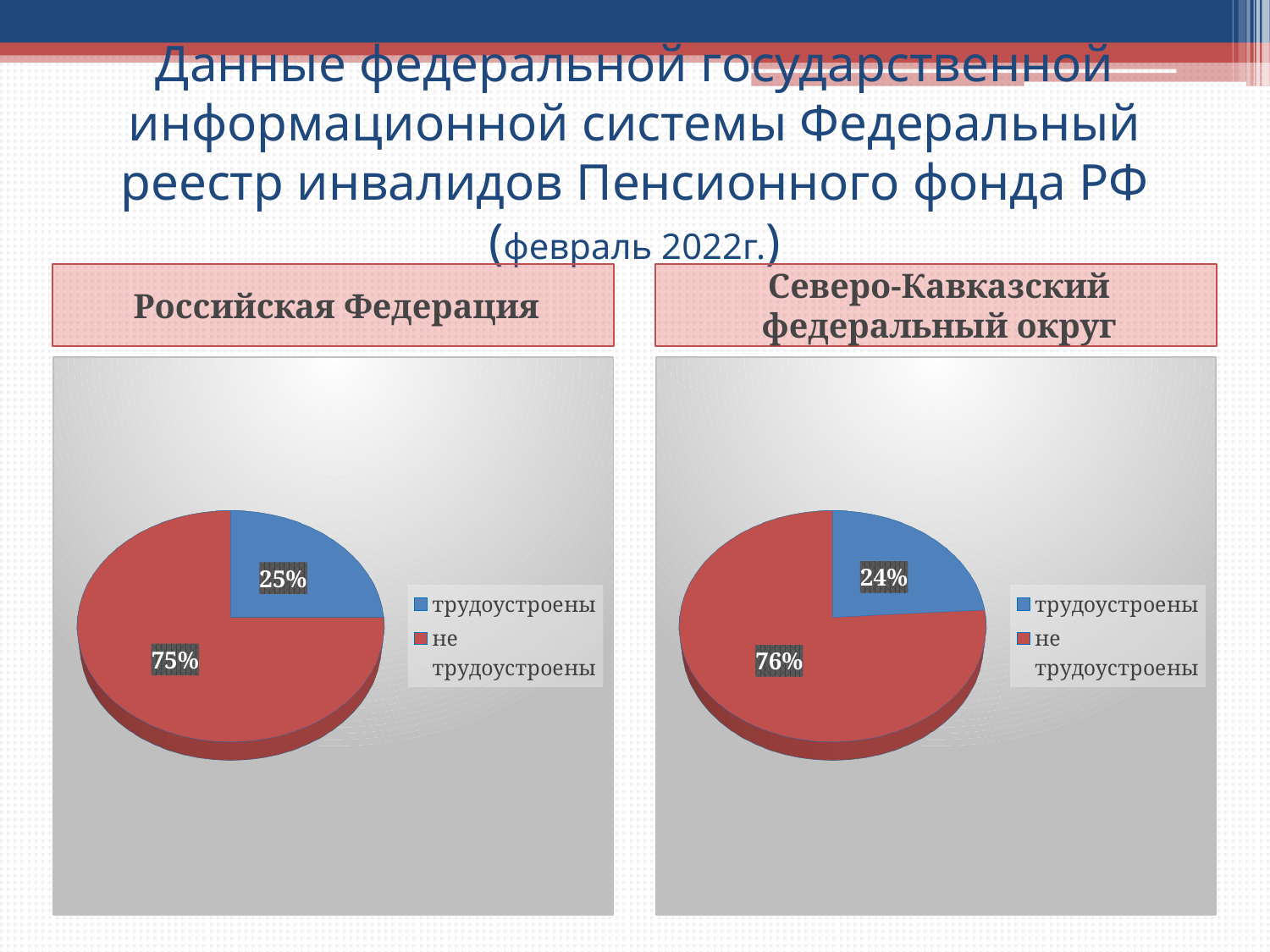
Which is larger: the 'трудоустроены' share in the 'Российская Федерация' chart or in the 'Северо-Кавказский федеральный округ' chart? Российская Федерация How many slices does the 'Северо-Кавказский федеральный округ' pie chart have? 2 In the 'Российская Федерация' chart, which category has the largest slice? не трудоустроены In the 'Российская Федерация' chart, what share is labelled 'трудоустроены'? 25% In the 'Российская Федерация' chart, what is the difference between the 'не трудоустроены' and 'трудоустроены' shares? 50% In the 'Северо-Кавказский федеральный округ' chart, which category has the smallest slice? трудоустроены What type of chart is used in the 'Российская Федерация' chart? Pie chart In the 'Российская Федерация' chart, what colour is the 'не трудоустроены' slice? Red In the 'Северо-Кавказский федеральный округ' chart, what share is labelled 'не трудоустроены'? 76% In the 'Российская Федерация' chart, what share is labelled 'не трудоустроены'? 75% In the 'Северо-Кавказский федеральный округ' chart, what is the difference between the 'не трудоустроены' and 'трудоустроены' shares? 52% In the 'Северо-Кавказский федеральный округ' chart, what share is labelled 'трудоустроены'? 24%